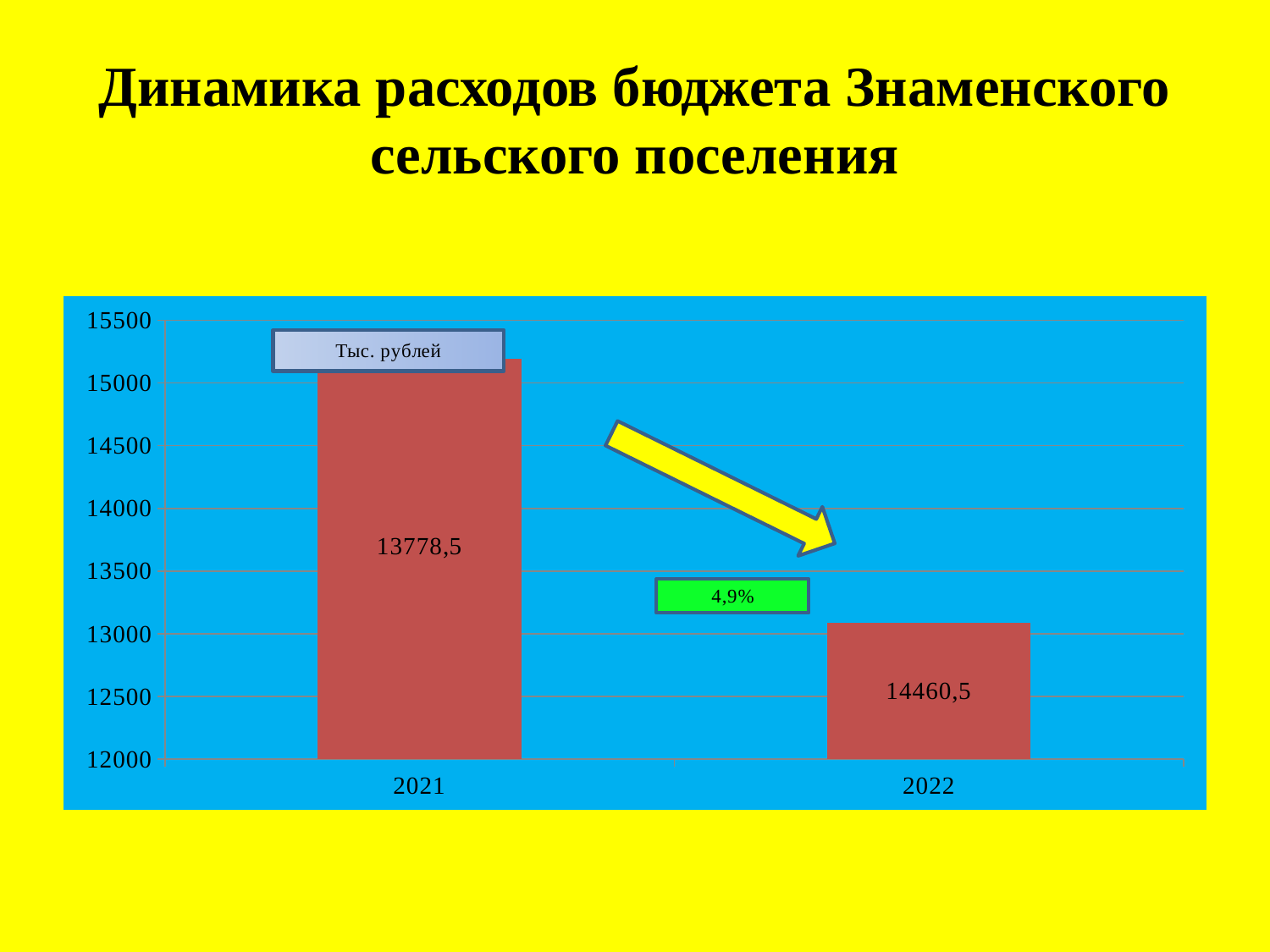
How many years are shown on the x axis of the chart? 2 Which two years are labelled on the x axis? 2021 and 2022 What unit is indicated in the box at the top of the chart? Тыс. рублей What percentage is shown in the green box between the two bars? 4,9% What is the highest value printed on the vertical axis? 15500 What is the title of the slide? Динамика расходов бюджета Знаменского сельского поселения What kind of chart is shown on the slide? bar chart What is the value shown for 2021? 13778,5 What is the lowest value printed on the vertical axis? 12000 What is the value shown for 2022? 14460,5